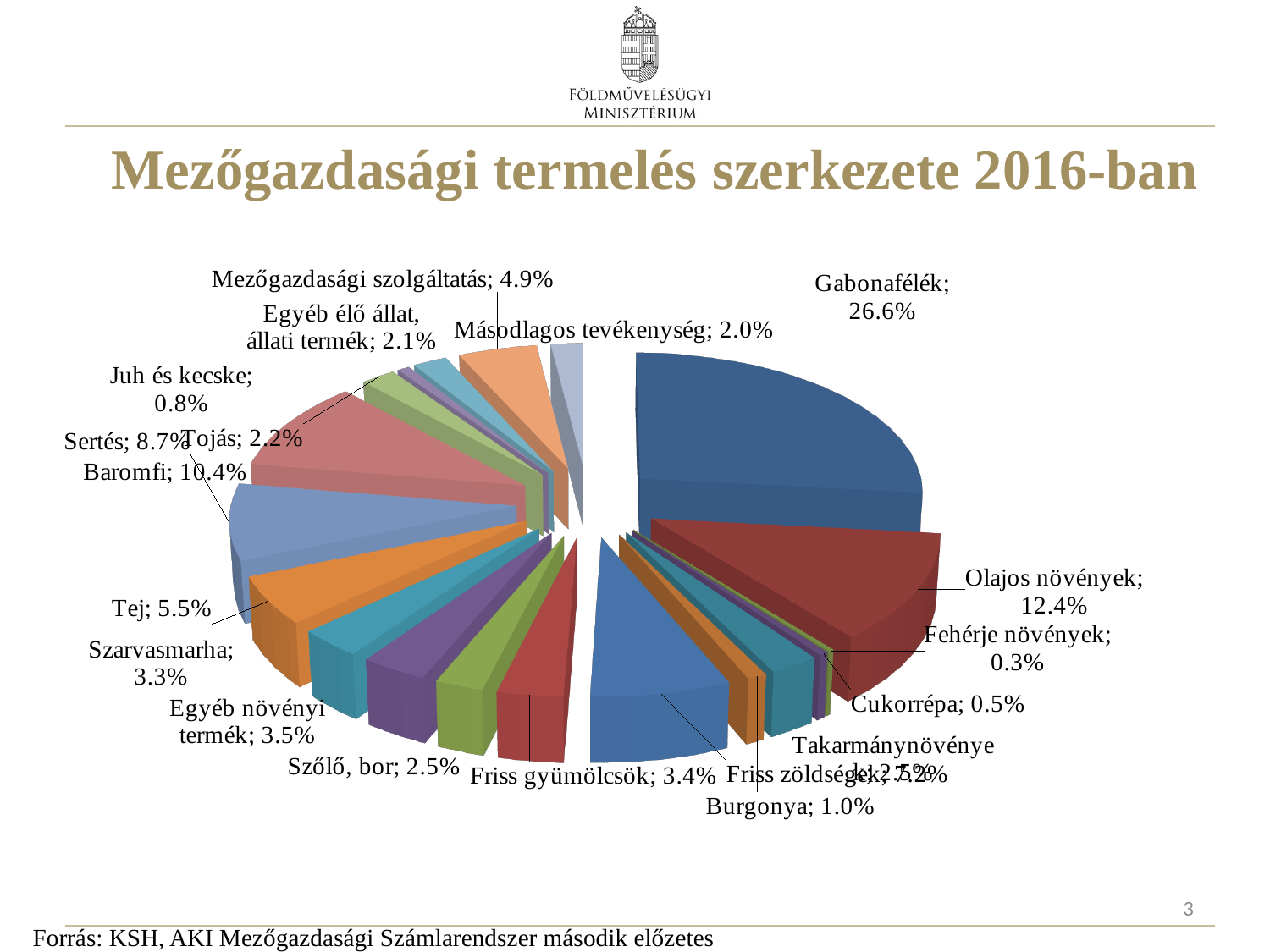
Which category has the largest share of the pie? Gabonafélék What is the share for Baromfi? 10.4% What is the share for Mezőgazdasági szolgáltatás? 4.9% What is the share for Juh és kecske? 0.8% What is the difference in percentage points between Gabonafélék and Olajos növények? 14.2 What is the share for Olajos növények? 12.4% What is the difference in percentage points between Baromfi and Sertés? 1.7 What is the share for Gabonafélék? 26.6% What is the title of the chart? Mezőgazdasági termelés szerkezete 2016-ban Which has a larger share, Sertés or Tej? Sertés Which category has the smallest share of the pie? Fehérje növények What kind of chart is shown on the slide? Pie chart